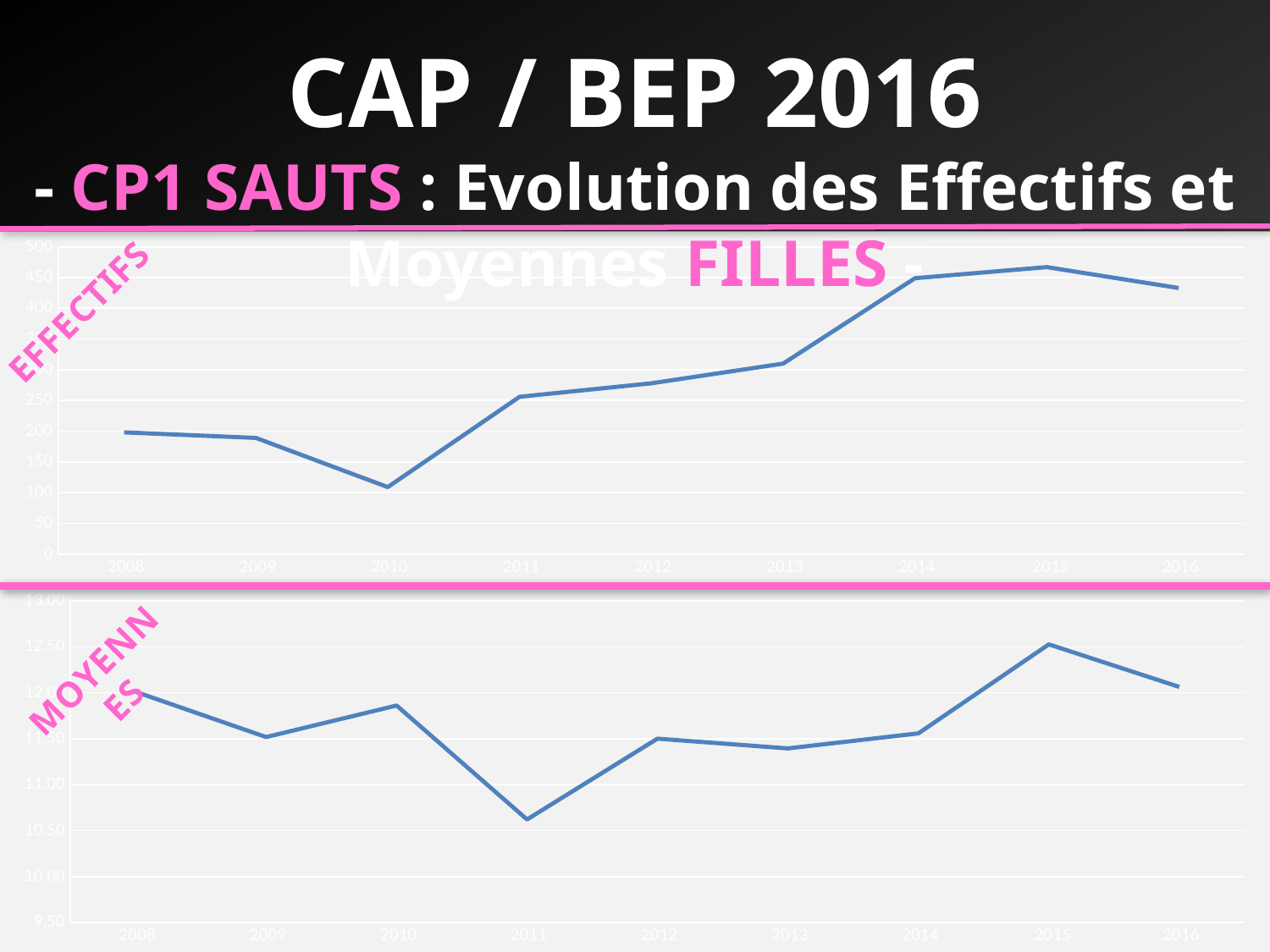
In the top chart (EFFECTIFS), is the value for 2010 greater or less than 150? less In the top chart (EFFECTIFS), which is larger, the value for 2011 or the value for 2013? 2013 What kind of chart is the top chart (EFFECTIFS)? line chart In the bottom chart (MOYENNES), which year has the lowest value? 2011 In the top chart (EFFECTIFS), which year has the lowest value? 2010 In the top chart (EFFECTIFS), do the values rise or fall between 2010 and 2015? rise In the top chart (EFFECTIFS), which year has the highest value? 2015 In the bottom chart (MOYENNES), which is larger, the value for 2015 or the value for 2016? 2015 In the top chart (EFFECTIFS), is the value for 2014 greater or less than 400? greater How many years are plotted on the x axis of the top chart (EFFECTIFS)? 9 In the bottom chart (MOYENNES), which year has the highest value? 2015 In the bottom chart (MOYENNES), is the value for 2011 greater or less than 11.00? less